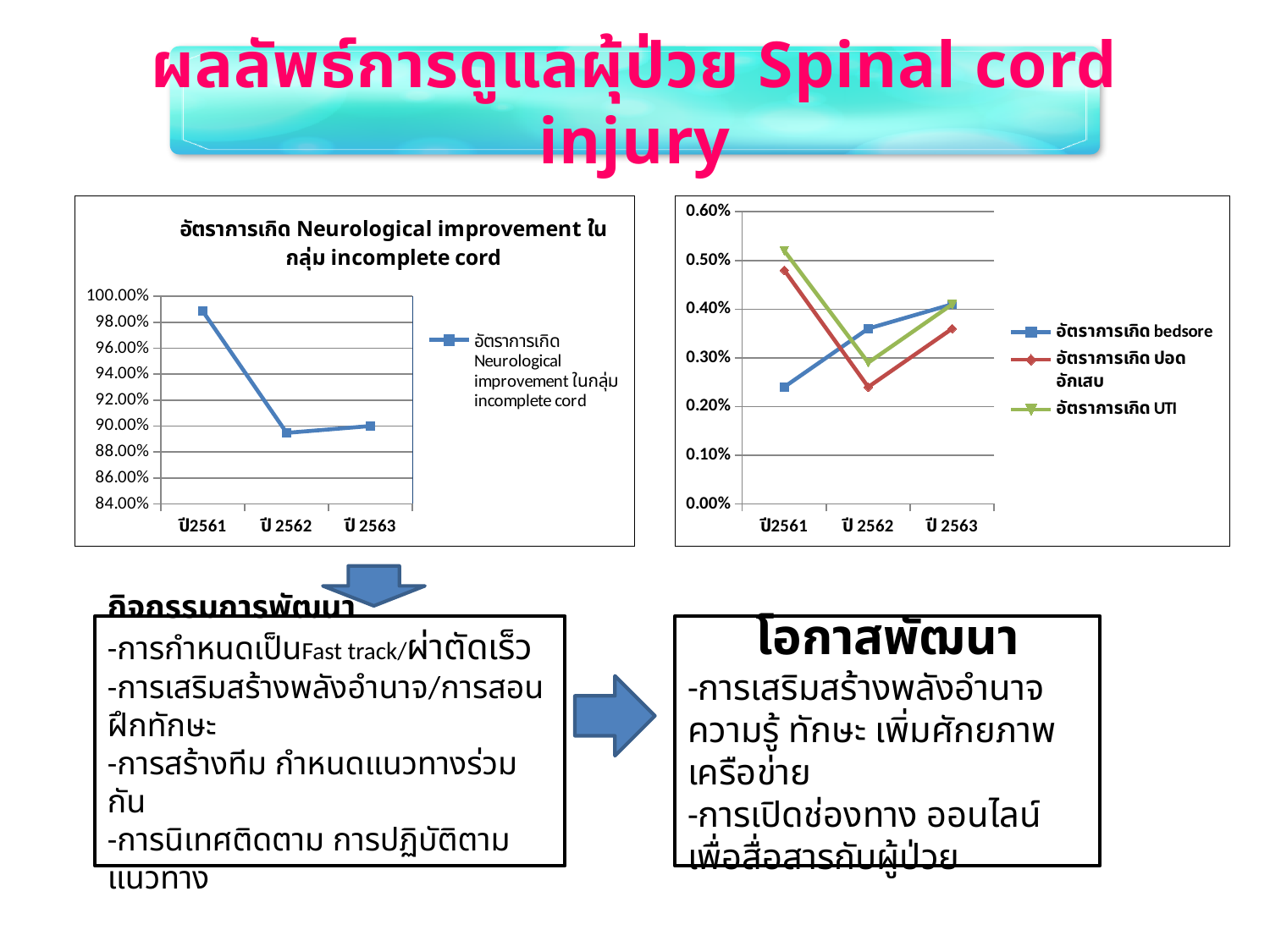
In the left chart (Neurological improvement), is the value for ปี 2562 greater or less than 92.00%? less In the left chart (Neurological improvement), is the value for ปี2561 greater or less than 96.00%? greater In the right chart, is the value of อัตราการเกิด bedsore for ปี2561 greater or less than 0.30%? less In the right chart, what colour is the line for อัตราการเกิด bedsore? blue In the right chart, does the อัตราการเกิด bedsore line rise or fall from ปี2561 to ปี 2563? rise In the left chart (Neurological improvement), does the value rise or fall from ปี2561 to ปี 2562? fall In the right chart, which is larger for ปี2561: อัตราการเกิด bedsore or อัตราการเกิด ปอดอักเสบ? อัตราการเกิด ปอดอักเสบ In the left chart (Neurological improvement), how many years are plotted on the x axis? 3 In the right chart, how many series does the legend list? 3 What kind of chart is the left chart titled 'อัตราการเกิด Neurological improvement ในกลุ่ม incomplete cord'? line chart In the left chart (Neurological improvement), which year has the highest value? ปี2561